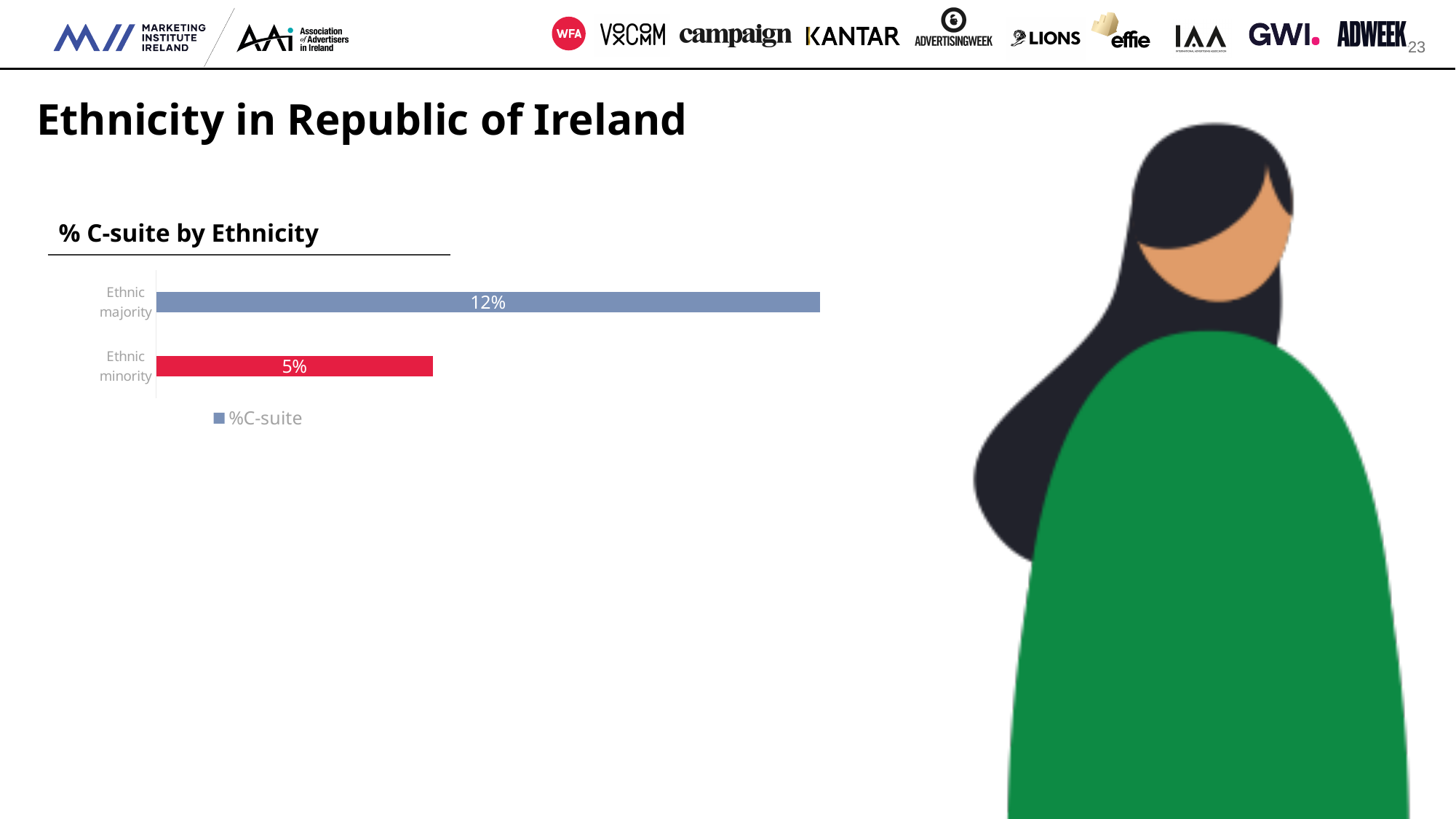
How many series does the legend list? 1 What kind of chart is shown on the slide? Bar chart What series name is shown in the chart legend? %C-suite Which category has the highest % C-suite value? Ethnic majority What is the % C-suite value for Ethnic majority? 12% What is the % C-suite value for Ethnic minority? 5% Which category has the lowest % C-suite value? Ethnic minority Which is larger, the % C-suite for Ethnic majority or for Ethnic minority? Ethnic majority How many categories are shown in the chart? 2 What is the difference in % C-suite between Ethnic majority and Ethnic minority? 7% What is the title of the chart? % C-suite by Ethnicity